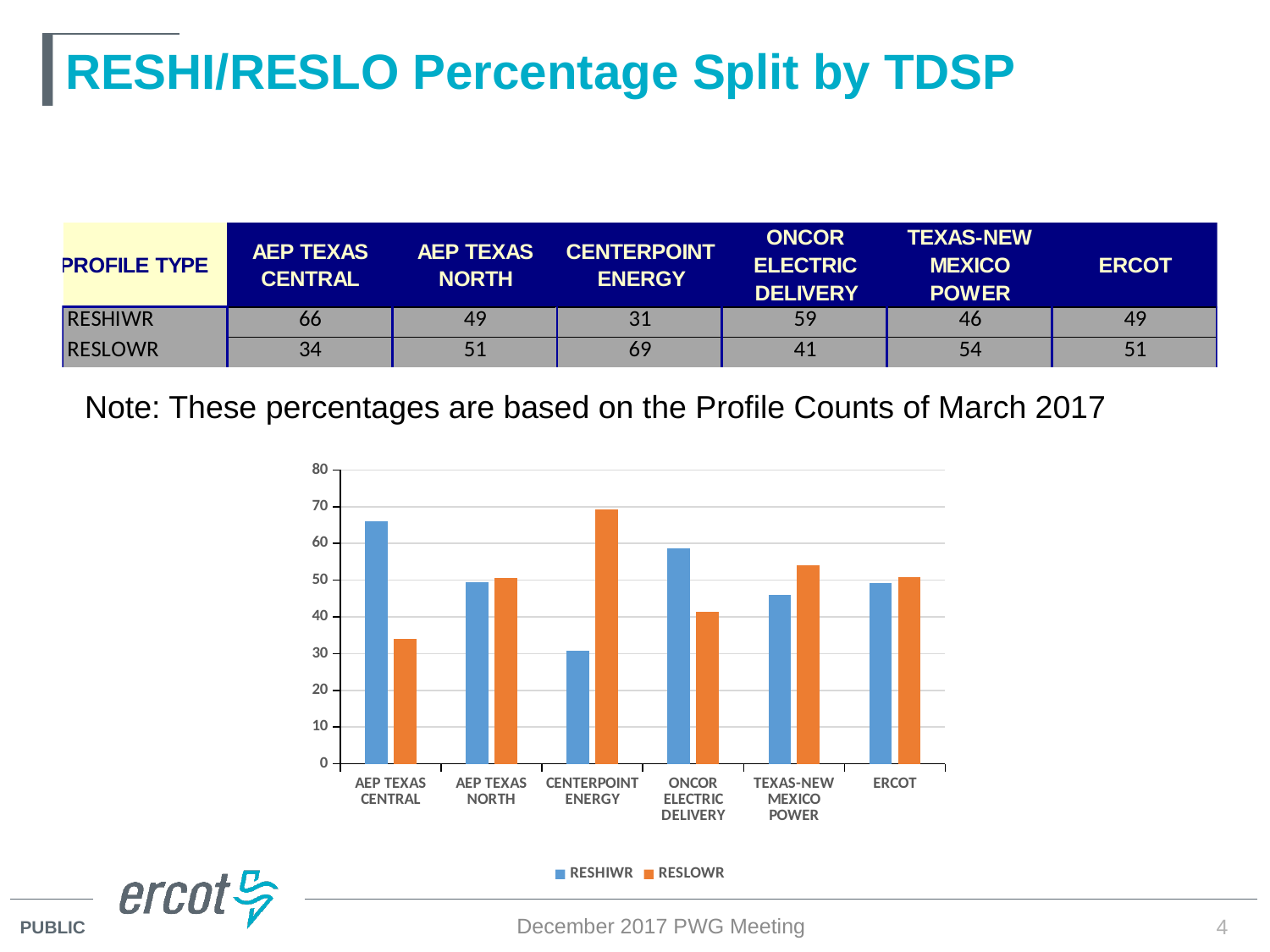
What is the RESHIWR value for AEP TEXAS CENTRAL? 66 What is the RESLOWR value for CENTERPOINT ENERGY? 69 For TEXAS-NEW MEXICO POWER, which is larger, RESHIWR or RESLOWR? RESLOWR Which series is shown in orange in the chart? RESLOWR What type of chart is shown on the slide? bar chart How many TDSP categories are shown on the x axis of the chart? 6 Which category has the lowest RESLOWR value? AEP TEXAS CENTRAL What is the difference between the RESHIWR and RESLOWR values for ONCOR ELECTRIC DELIVERY? 18 Which category has the lowest RESHIWR value? CENTERPOINT ENERGY Which category has the highest RESHIWR value? AEP TEXAS CENTRAL How many series does the chart legend list? 2 Is the RESHIWR value for ONCOR ELECTRIC DELIVERY greater or less than 50? greater